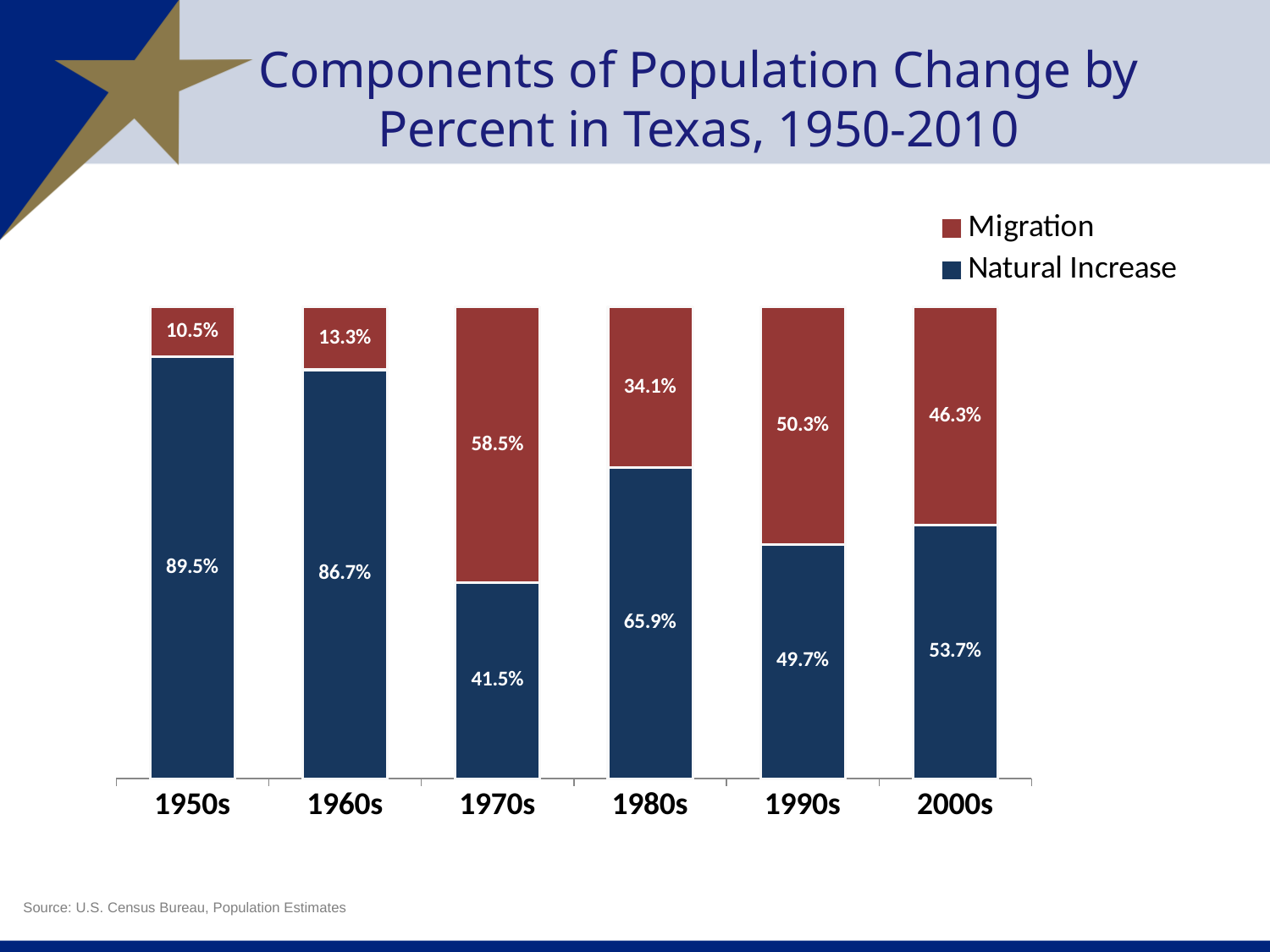
What is the Natural Increase value for the 1980s? 65.9% How many decades are shown on the x axis? 6 Which series is shown in red? Migration What is the Migration value for the 1970s? 58.5% What is the difference between the Natural Increase values for the 1950s and the 1960s? 2.8% How many series does the legend list? 2 Which decade has the highest Migration value? 1970s What kind of chart is shown on the slide? Stacked bar chart What is the Natural Increase value for the 1950s? 89.5% What is the Migration value for the 2000s? 46.3% Which decade has the lowest Natural Increase value? 1970s Which is larger in the 1990s, Migration or Natural Increase? Migration